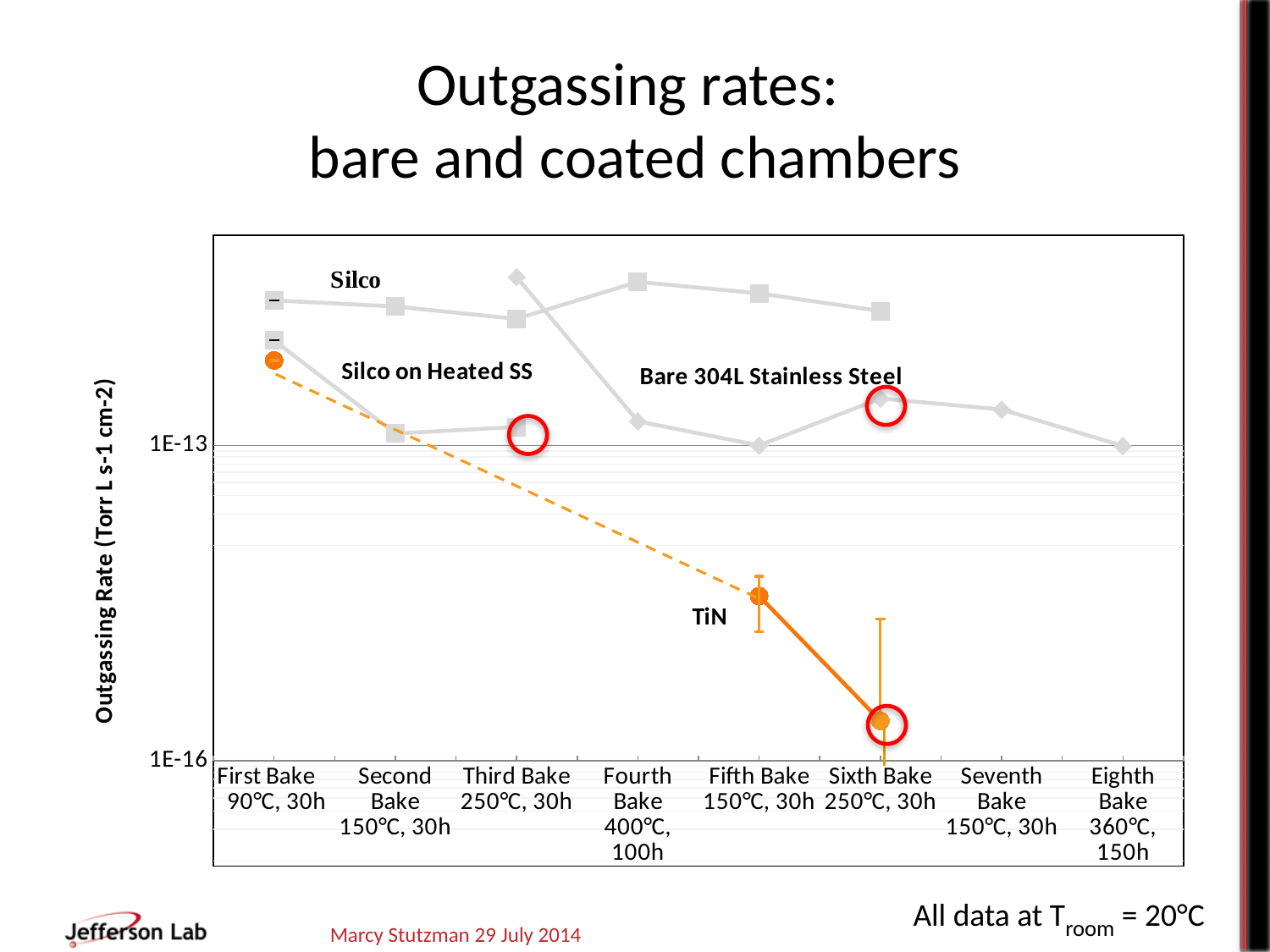
Is the Bare 304L Stainless Steel value at Third Bake 250°C, 30h greater or less than 1E-13? greater How many bake categories are shown along the x axis? 8 At First Bake 90°C, 30h, which series has the higher outgassing rate, Silco or TiN? Silco At which bake does the Bare 304L Stainless Steel series reach its highest value? Third Bake 250°C, 30h Is the Silco value at First Bake 90°C, 30h greater or less than 1E-13? greater What is the label of the y axis? Outgassing Rate (Torr L s-1 cm-2) What kind of chart is shown on the slide? line chart Is the TiN value at Sixth Bake 250°C, 30h greater or less than 1E-13? less What is the title of the slide's chart? Outgassing rates: bare and coated chambers Do the TiN values rise or fall from First Bake to Sixth Bake? fall How many series are labelled on the chart? 4